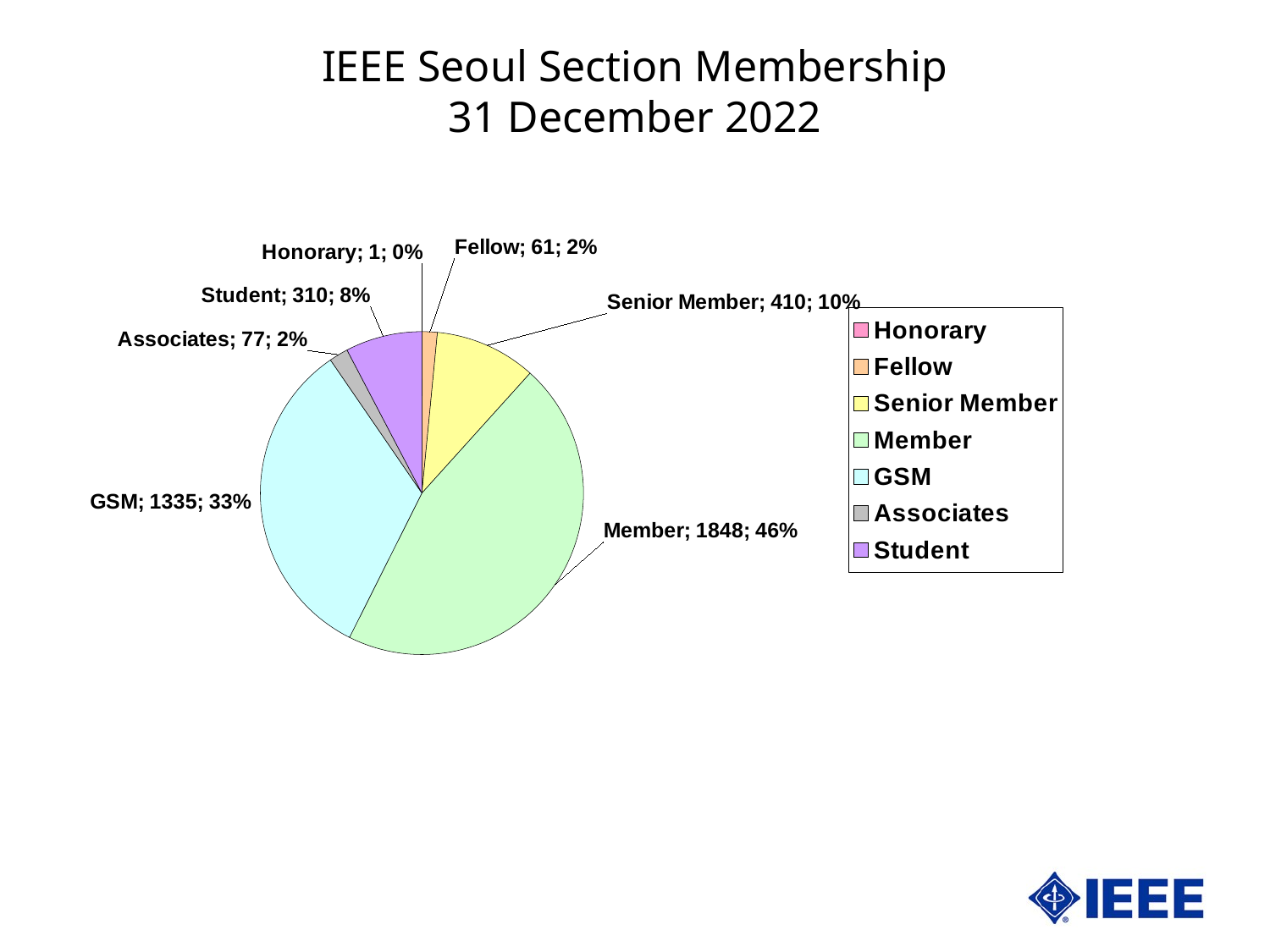
What share of the pie does the Member slice represent? 46% Which category has the largest slice? Member What is the difference between the Member and GSM values? 513 What is the title of the slide? IEEE Seoul Section Membership 31 December 2022 What is the value for Senior Member? 410 How many members are in the Member category? 1848 Which is larger, the value for Student or the value for Associates? Student What kind of chart is shown on the slide? pie chart How many categories does the pie chart have? 7 Which category has the smallest slice? Honorary What is the value for GSM? 1335 What share of the pie does the Student slice represent? 8%